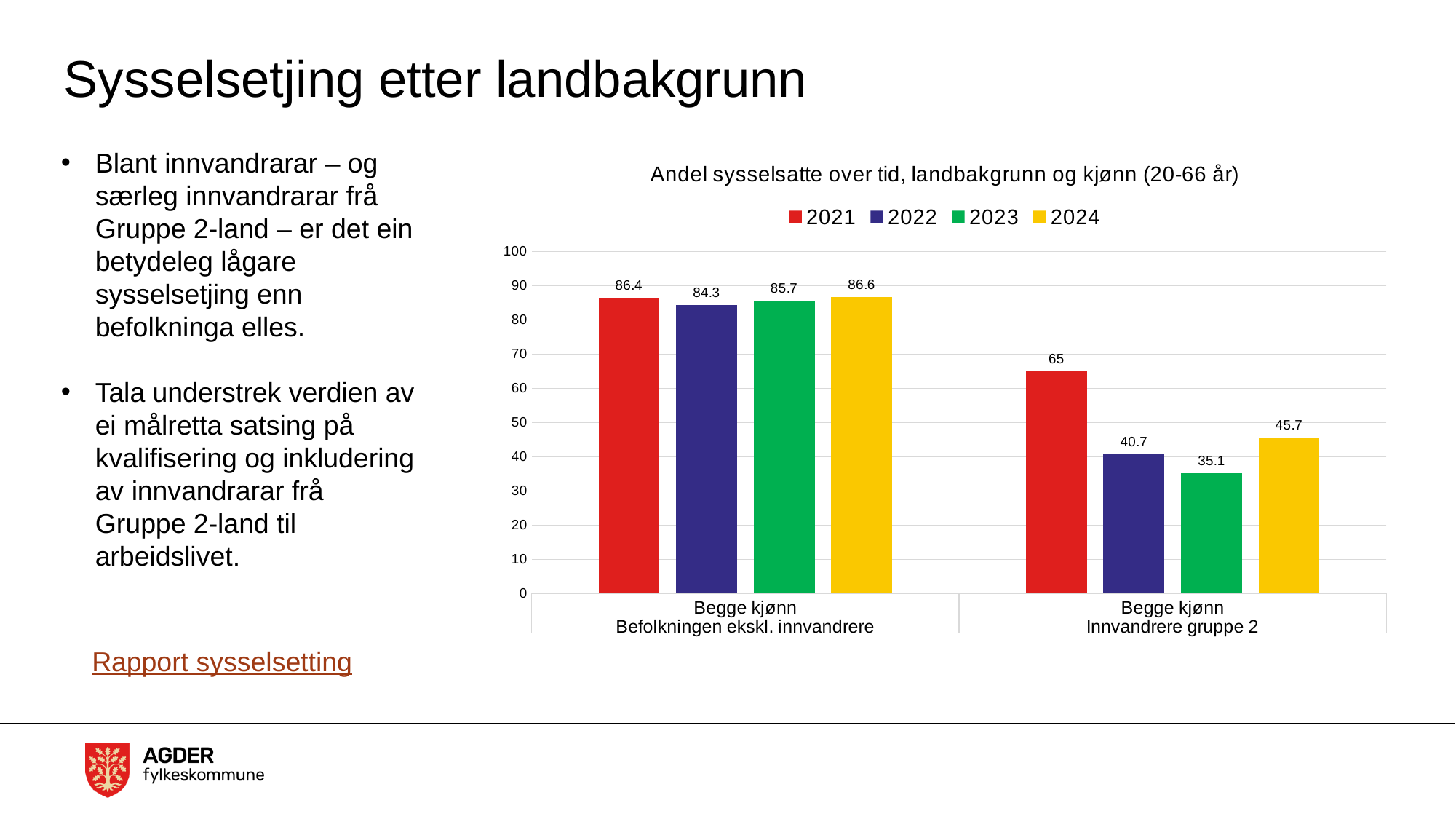
How many category groups are shown on the x axis? 2 What is the value for 2023 in the 'Begge kjønn Innvandrere gruppe 2' group? 35.1 What kind of chart is shown on the slide? Bar chart How many series does the legend list? 4 Which year has the highest value in the 'Begge kjønn Innvandrere gruppe 2' group? 2021 Which is larger: the 2024 value for 'Befolkningen ekskl. innvandrere' or the 2024 value for 'Innvandrere gruppe 2'? Befolkningen ekskl. innvandrere Which year has the lowest value in the 'Begge kjønn Befolkningen ekskl. innvandrere' group? 2022 What is the difference between the 2021 and 2022 values in the 'Begge kjønn Innvandrere gruppe 2' group? 24.3 What is the value for 2024 in the 'Begge kjønn Innvandrere gruppe 2' group? 45.7 What is the value for 2021 in the 'Begge kjønn Befolkningen ekskl. innvandrere' group? 86.4 What is the title of the chart? Andel sysselsatte over tid, landbakgrunn og kjønn (20-66 år) Is the 2022 value for 'Innvandrere gruppe 2' greater or less than 50? less